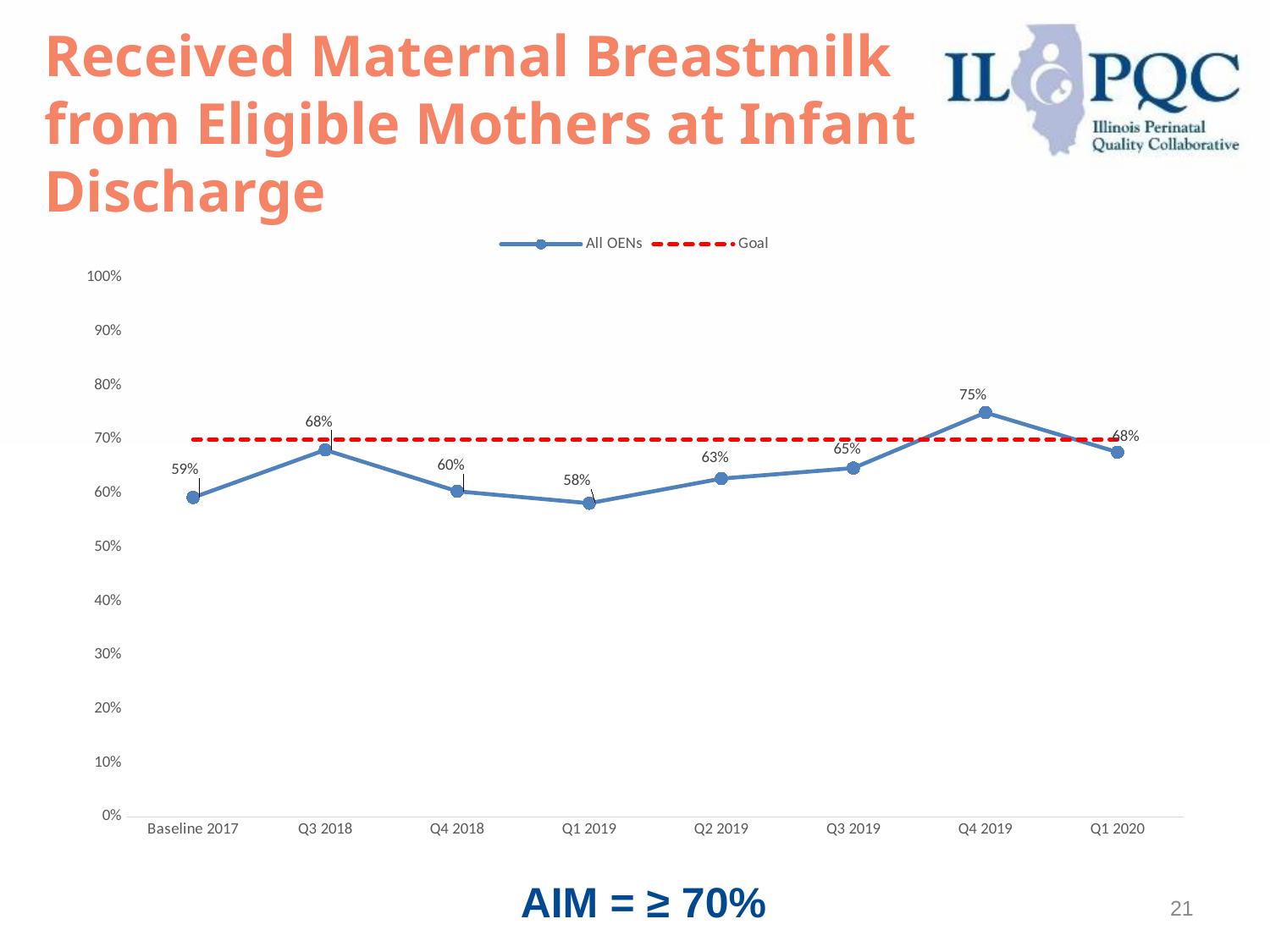
What is the difference between the All OENs values for Q4 2019 and Q1 2019? 17% How many time periods are shown on the x axis? 8 What is the value for All OENs at Q1 2020? 68% What kind of chart is shown on the slide? line chart How many series does the legend list? 2 Which period has the highest value for All OENs? Q4 2019 What value does the dashed Goal line sit at? 70% What is the value for All OENs at Baseline 2017? 59% Is the All OENs value for Q2 2019 greater or less than 70%? less Which is larger, the All OENs value for Q3 2018 or for Q4 2018? Q3 2018 Which period has the lowest value for All OENs? Q1 2019 What is the value for All OENs at Q4 2019? 75%